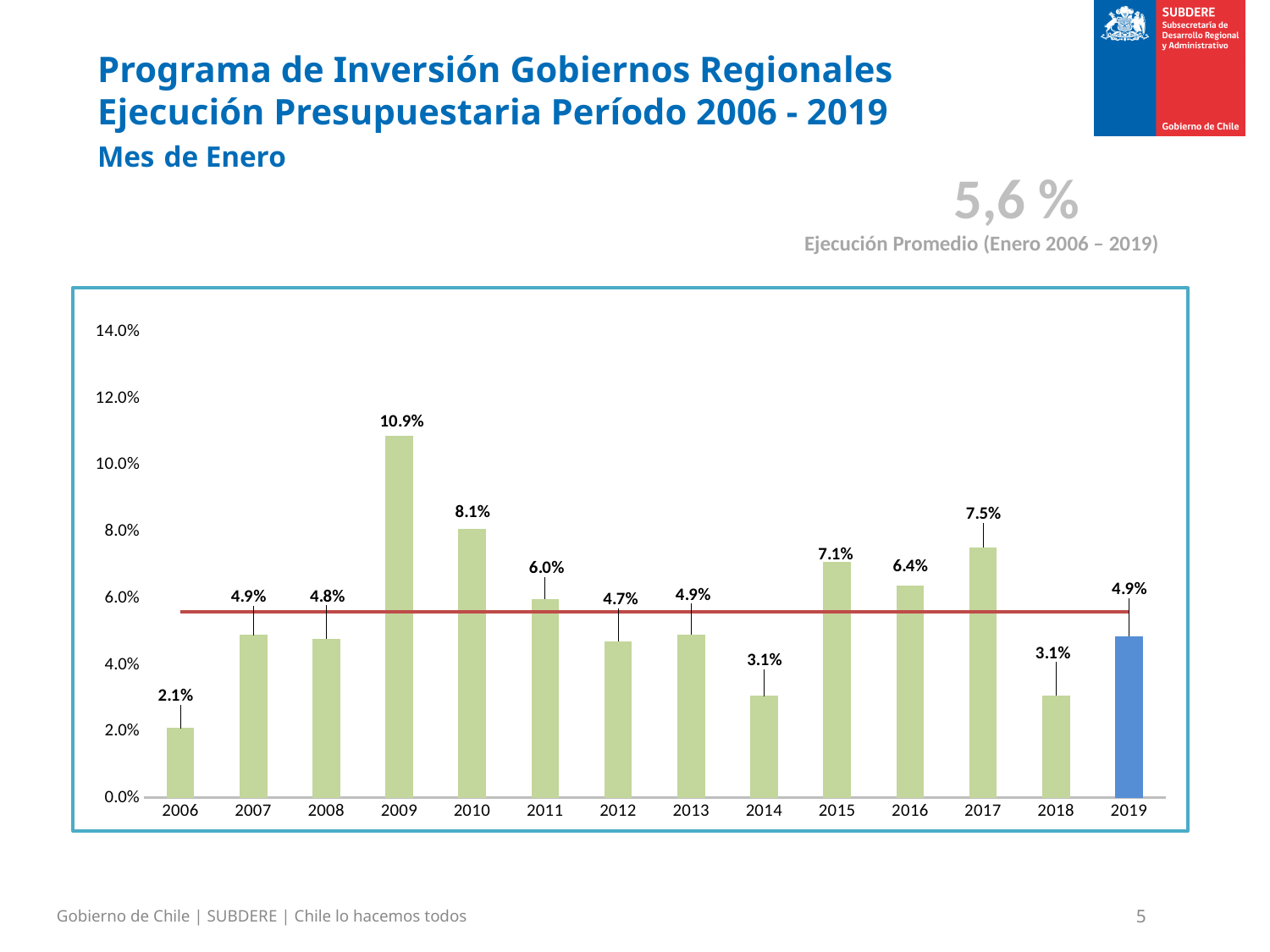
What is the value for 2009? 10.9% Do the values rise or fall from 2017 to 2018? Fall Is the value for 2017 greater or less than 6.0%? greater What kind of chart is shown on the slide? Bar chart What is the value for 2006? 2.1% Which is larger, the value for 2015 or the value for 2016? 2015 How many years are shown on the x axis? 14 Which year has the highest value? 2009 Which year has the lowest value? 2006 What is the difference between the values for 2009 and 2010? 2.8% What is the value for 2019? 4.9% What average execution value is shown above the chart for January 2006–2019? 5,6 %